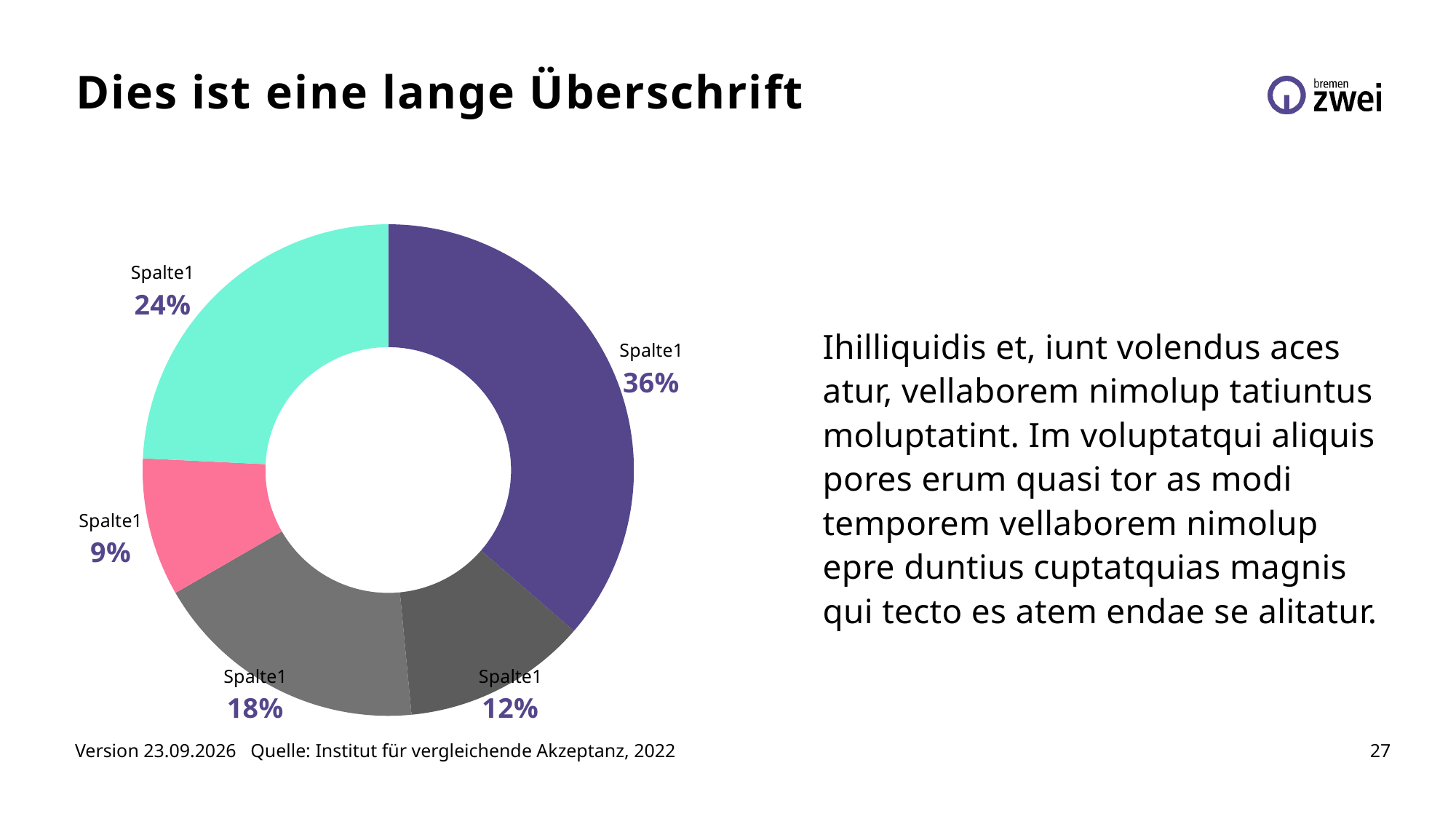
What percentage is shown for the purple slice of the donut chart? 36% What percentage is shown for the dark grey slice at the bottom right of the donut chart? 12% Which slice is larger, the light grey slice or the dark grey slice? The light grey slice (18%) What percentage is shown for the pink slice of the donut chart? 9% What percentage is shown for the light grey slice at the bottom left of the donut chart? 18% What is the difference between the purple slice (36%) and the mint-green slice (24%)? 12% What kind of chart is shown on the slide? Pie chart (donut) What label is shown for every slice of the donut chart? Spalte1 What percentage is shown for the mint-green slice of the donut chart? 24% What is the smallest percentage shown on the donut chart? 9% What is the largest percentage shown on the donut chart? 36% How many slices does the donut chart have? 5